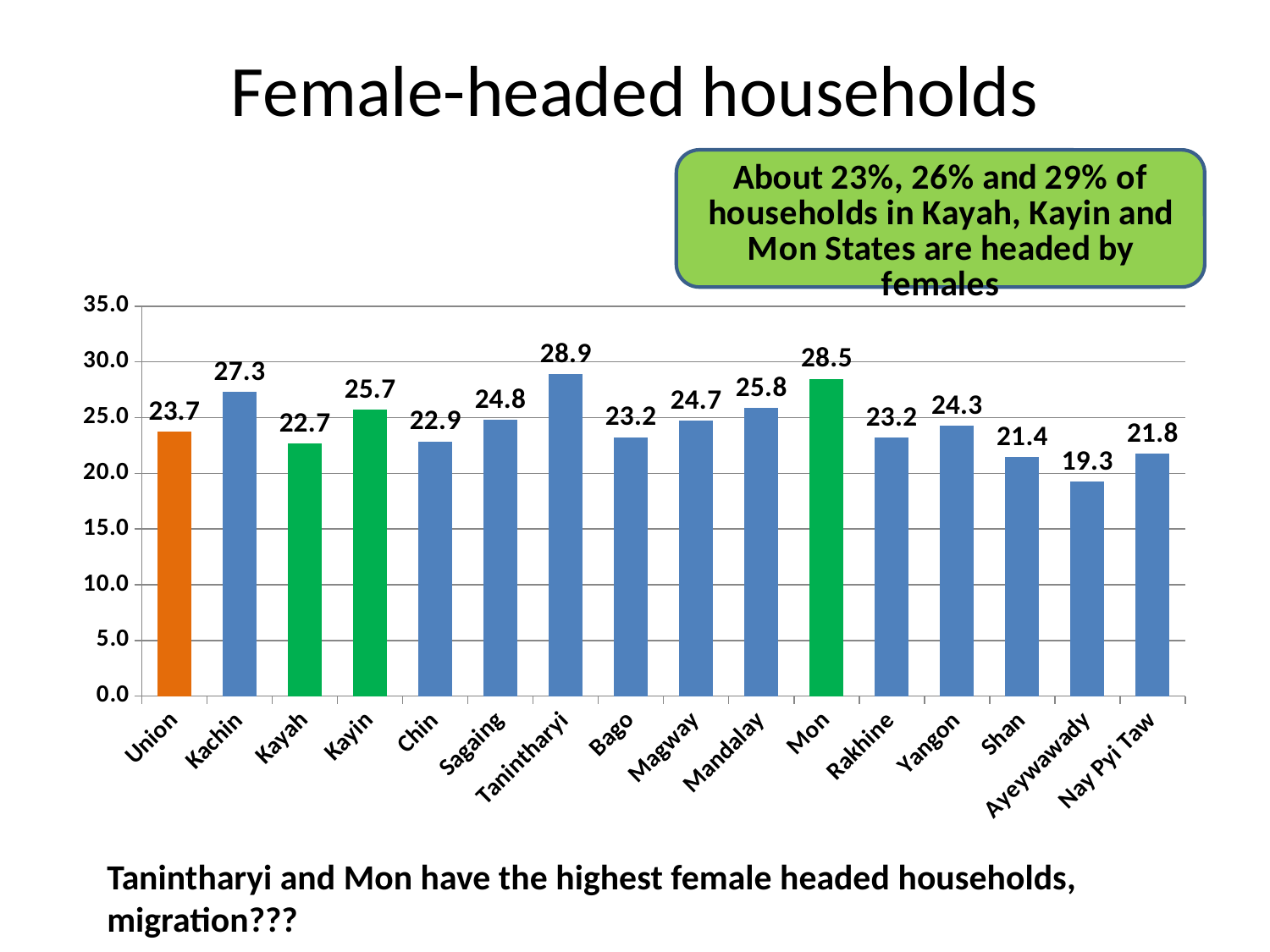
Which category has the highest value? Tanintharyi How many categories are shown on the x axis? 16 What kind of chart is shown on the slide? bar chart What is the difference between the values for Tanintharyi and Mon? 0.4 What is the value for Tanintharyi? 28.9 What is the difference between the values for Kachin and Kayah? 4.6 Which category has the lowest value? Ayeywawady Is the value for Shan greater or less than 25.0? less What colour is the bar for Union? orange What is the value for Ayeywawady? 19.3 What is the value for Union? 23.7 Which is larger, the value for Kachin or the value for Yangon? Kachin